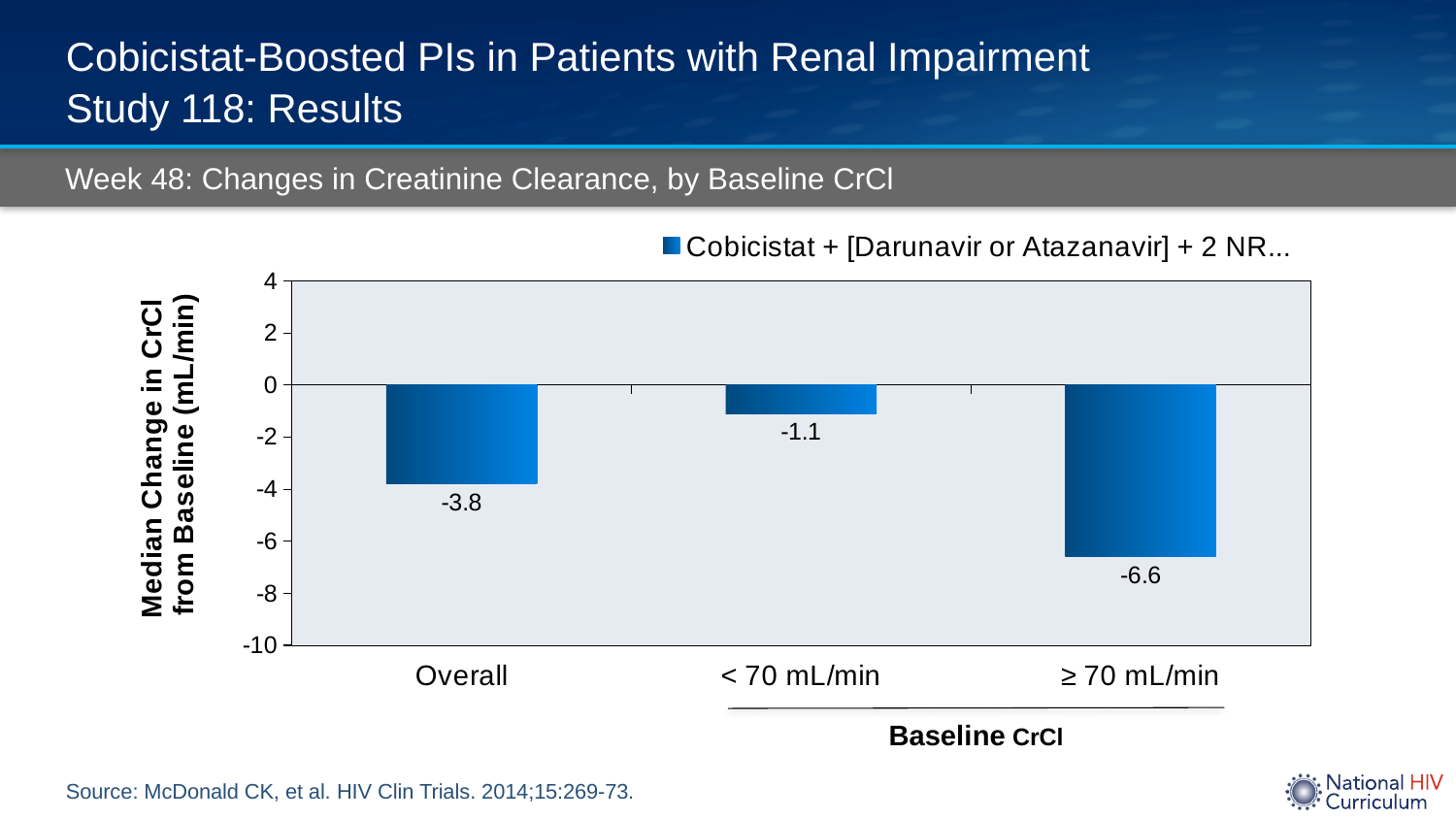
What is the median change in CrCl from baseline for patients with baseline CrCl ≥ 70 mL/min? -6.6 Which category shows the smallest decrease in CrCl from baseline? < 70 mL/min What is the label of the y axis? Median Change in CrCl from Baseline (mL/min) What kind of chart is shown on the slide? Bar chart Which group has a larger decrease in CrCl: Overall or < 70 mL/min? Overall How many series does the legend list? 1 What is the difference between the median change for the ≥ 70 mL/min group and the < 70 mL/min group? 5.5 How many categories are shown on the x axis? 3 What is the median change in CrCl from baseline for patients with baseline CrCl < 70 mL/min? -1.1 Which category shows the largest decrease in CrCl from baseline? ≥ 70 mL/min What is the median change in CrCl from baseline for the Overall group? -3.8 Is the value for the ≥ 70 mL/min group greater or less than -6? less